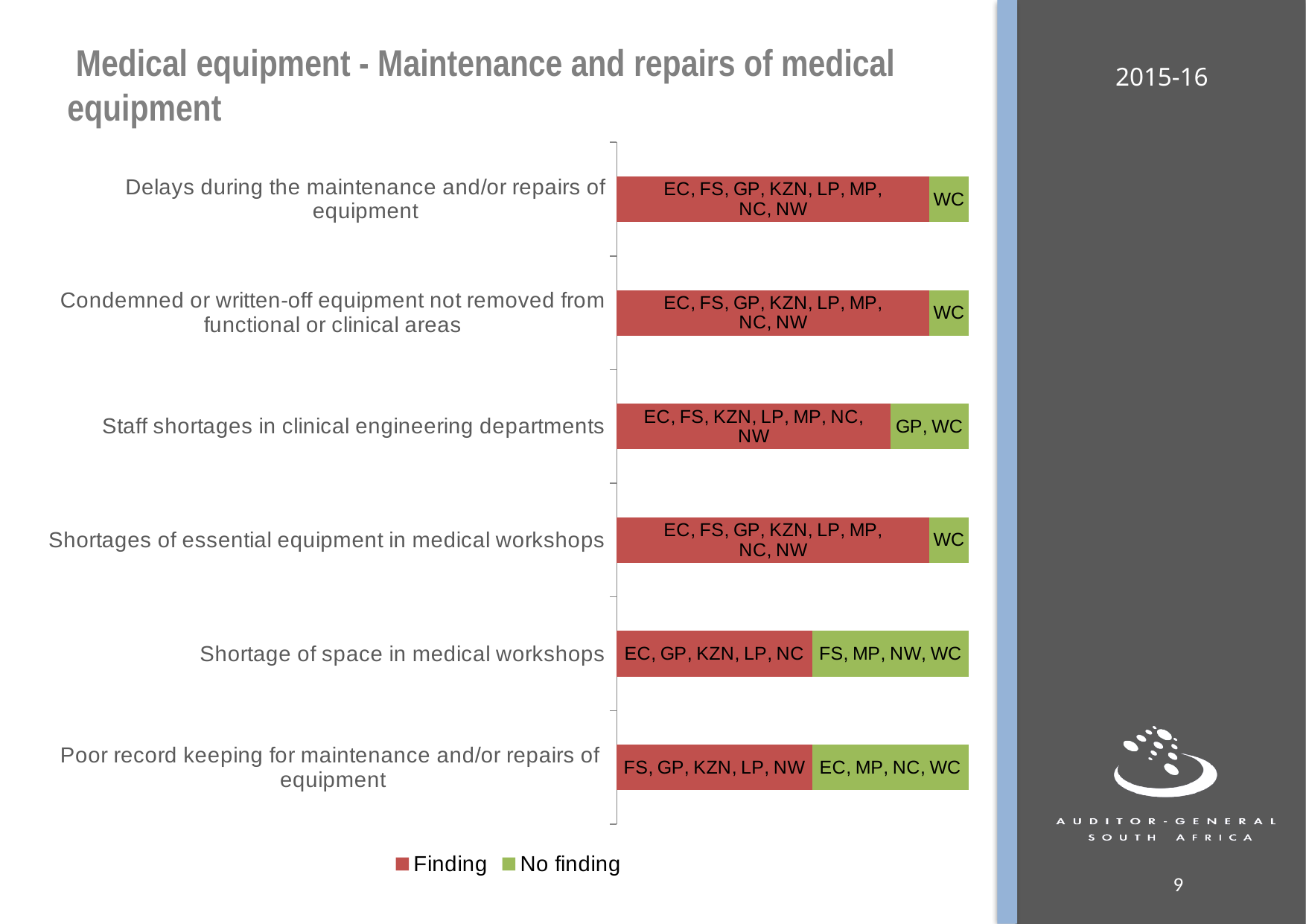
Which category has the largest 'No finding' segment? Shortage of space in medical workshops and Poor record keeping for maintenance and/or repairs of equipment (tied, 4 provinces each) Which provinces are labelled in the 'Finding' segment for 'Shortage of space in medical workshops'? EC, GP, KZN, LP, NC Which provinces are labelled in the 'No finding' segment for 'Delays during the maintenance and/or repairs of equipment'? WC How many series does the legend list? 2 Which provinces are labelled in the 'Finding' segment for 'Condemned or written-off equipment not removed from functional or clinical areas'? EC, FS, GP, KZN, LP, MP, NC, NW Which provinces are labelled in the 'No finding' segment for 'Poor record keeping for maintenance and/or repairs of equipment'? EC, MP, NC, WC Which provinces are labelled in the 'No finding' segment for 'Staff shortages in clinical engineering departments'? GP, WC What kind of chart is shown on the slide? Stacked bar chart How many categories (findings) are listed on the chart? 6 What colour represents the 'Finding' series? Red Is the 'Finding' segment larger for 'Staff shortages in clinical engineering departments' or for 'Shortage of space in medical workshops'? Staff shortages in clinical engineering departments What are the two series named in the legend? Finding, No finding